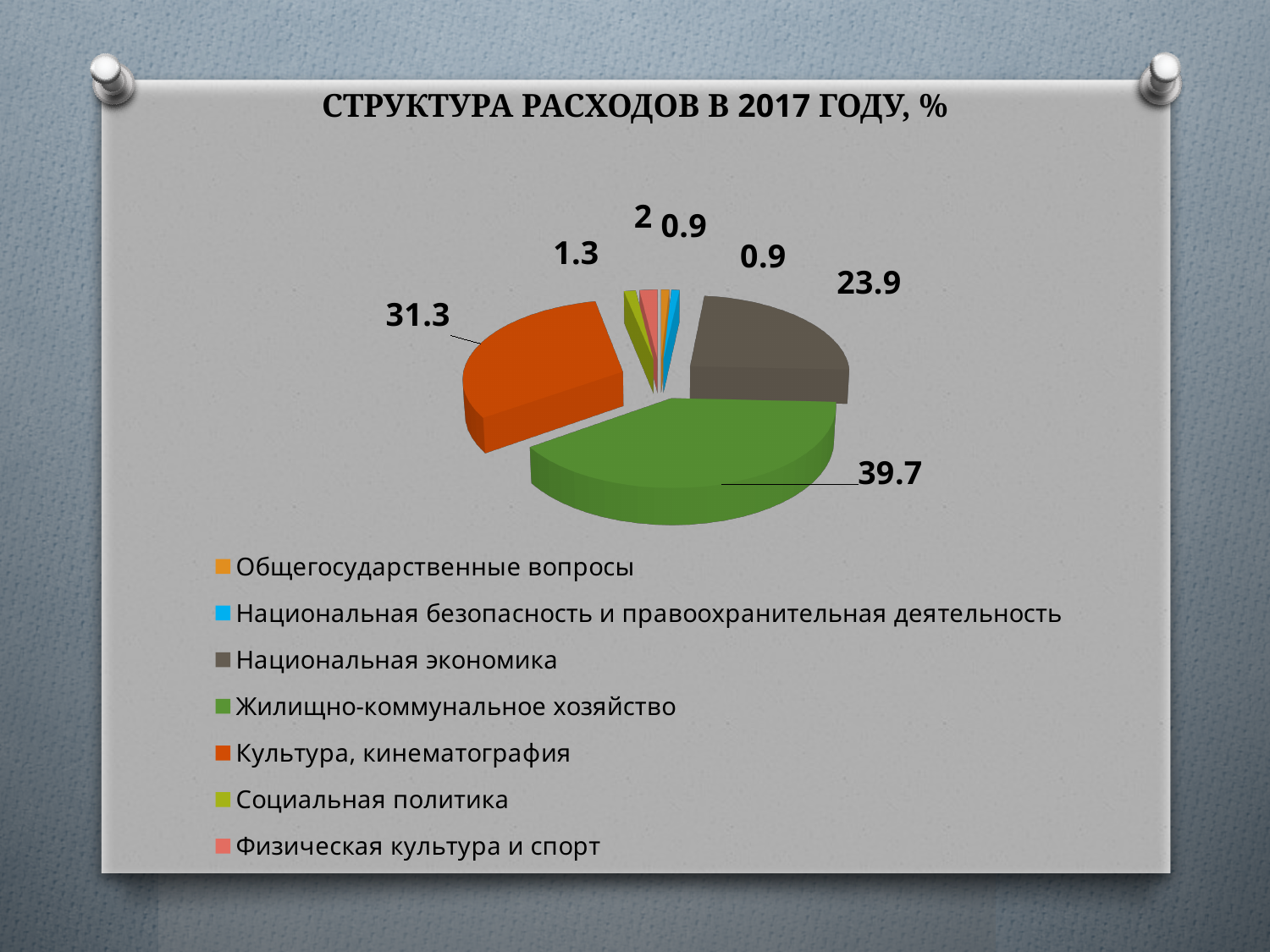
What is the value for Культура, кинематография? 31.3 What kind of chart is shown on the slide? Pie chart How many categories does the legend list? 7 What colour is the slice for Жилищно-коммунальное хозяйство? Green What is the smallest value shown on the chart? 0.9 Which is larger: Национальная экономика or Культура, кинематография? Культура, кинематография What is the difference between the values for Жилищно-коммунальное хозяйство and Культура, кинематография? 8.4 What is the value for Национальная экономика? 23.9 What is the value for Жилищно-коммунальное хозяйство? 39.7 What is the title of the chart? СТРУКТУРА РАСХОДОВ В 2017 ГОДУ, % What is the difference between the values for Культура, кинематография and Национальная экономика? 7.4 Which category has the largest share of the pie? Жилищно-коммунальное хозяйство